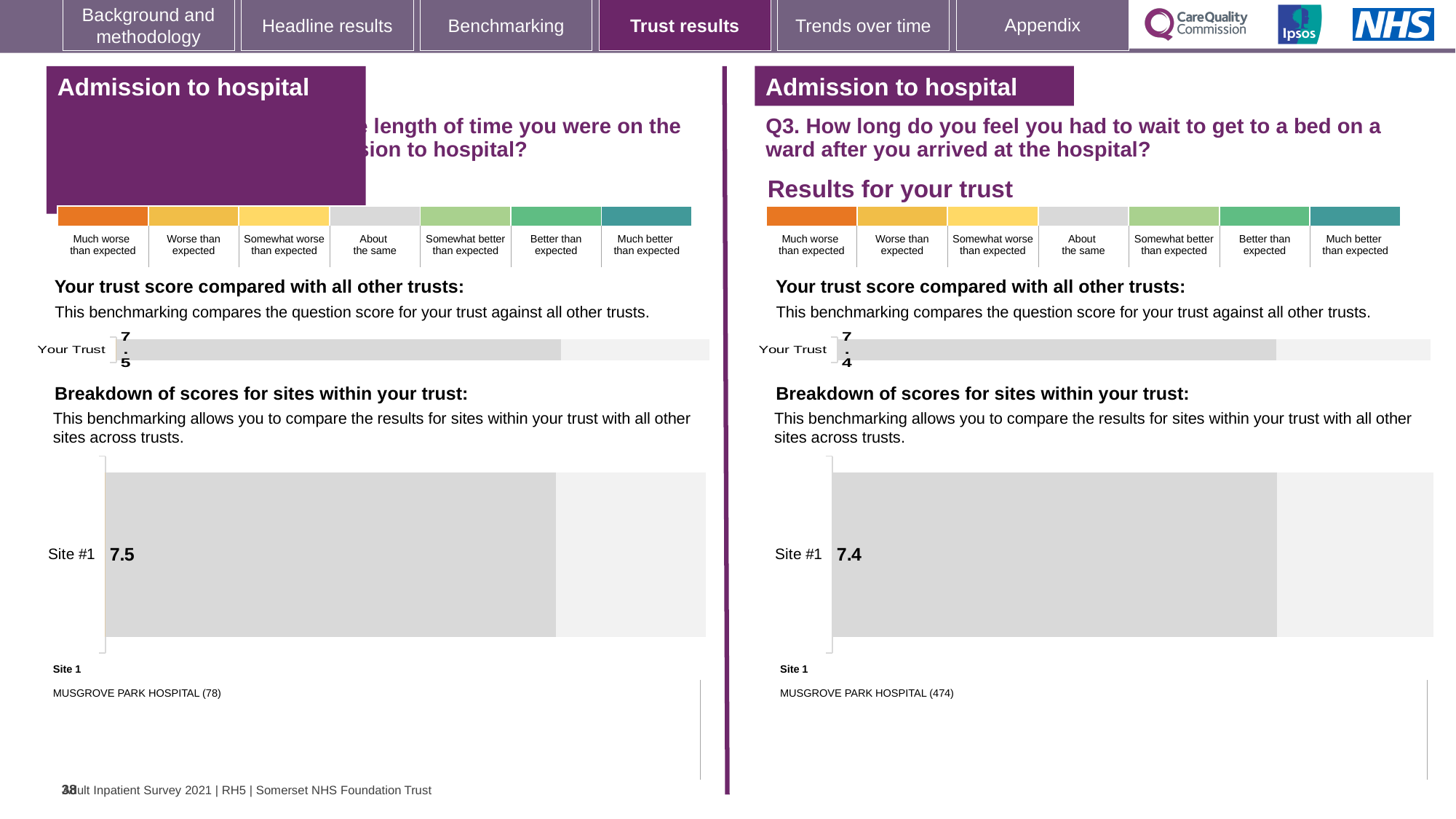
On the right half of the slide (Q3), is the Your Trust score equal to the Site #1 score? Yes, both are 7.4 On the right half of the slide (Q3), what score is shown for Site #1 in the 'Breakdown of scores for sites within your trust' chart? 7.4 On the left half of the slide, what score is shown for Site #1 in the 'Breakdown of scores for sites within your trust' chart? 7.5 On the left half of the slide, which site is listed as Site 1 below the breakdown chart? MUSGROVE PARK HOSPITAL (78) What kind of chart is used to show the Site #1 score on the right half of the slide (Q3)? Bar chart On the right half of the slide (Q3), which site is listed as Site 1 below the breakdown chart? MUSGROVE PARK HOSPITAL (474) On the left half of the slide, what is the score shown for Your Trust in the 'Your trust score compared with all other trusts' chart? 7.5 On the right half of the slide (Q3), what is the score shown for Your Trust in the 'Your trust score compared with all other trusts' chart? 7.4 Which is larger: the Site #1 score on the left half of the slide or the Site #1 score on the right half (Q3)? Left half (7.5) What is the difference between the Site #1 score on the left half of the slide and the Site #1 score on the right half (Q3)? 0.1 How many sites are shown in the 'Breakdown of scores for sites within your trust' chart on the right half of the slide (Q3)? 1